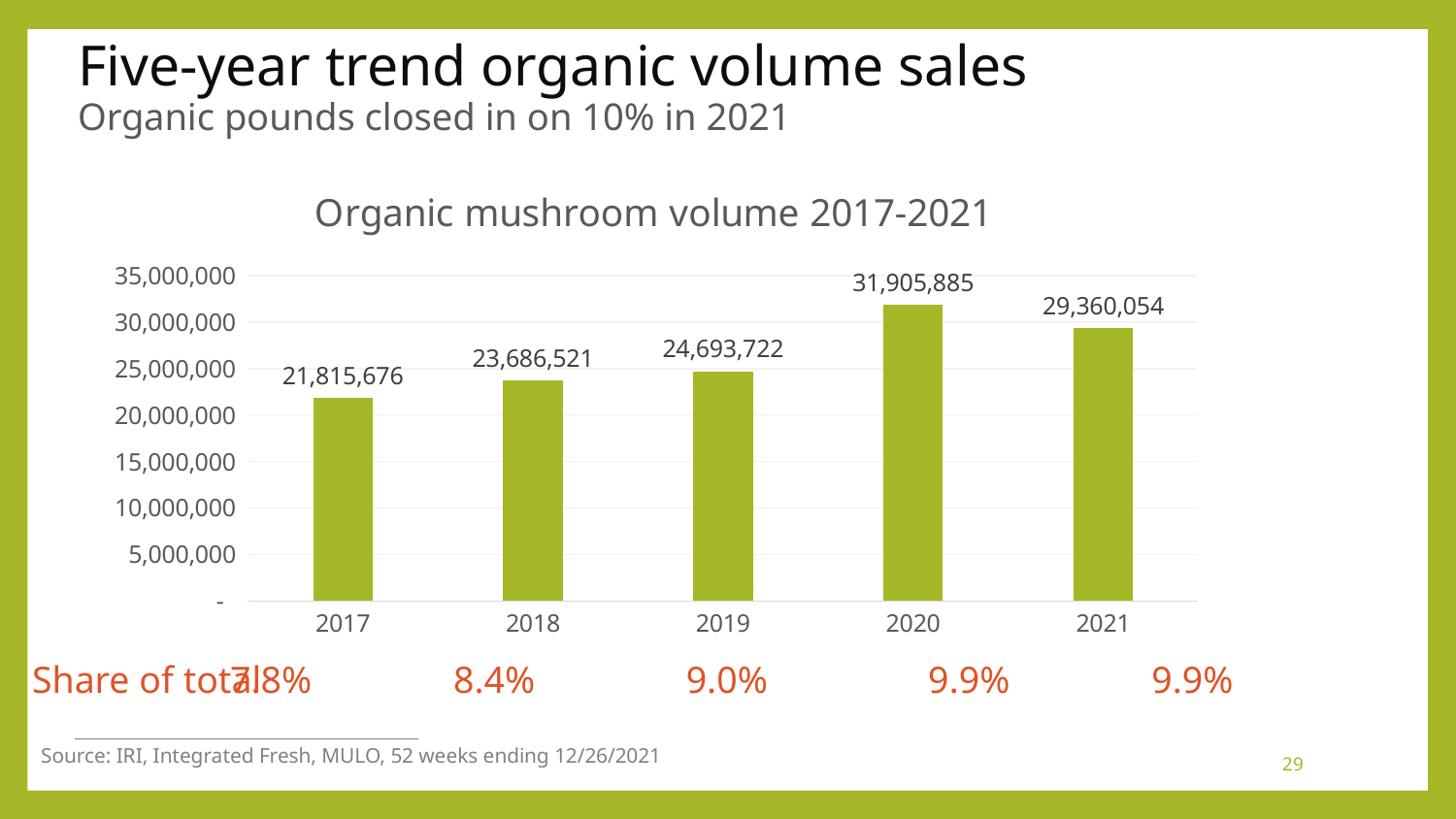
What is the organic mushroom volume for 2020? 31,905,885 What is the difference in organic mushroom volume between 2018 and 2017? 1,870,845 Did the organic mushroom volume rise or fall from 2020 to 2021? fall What is the organic mushroom volume for 2017? 21,815,676 How many years are shown in the chart? 5 Which year has the highest organic mushroom volume? 2020 What is the organic mushroom volume for 2021? 29,360,054 Is the organic mushroom volume for 2019 greater or less than 25,000,000? less Which year has a larger organic mushroom volume, 2019 or 2021? 2021 Which year has the lowest organic mushroom volume? 2017 What is the difference in organic mushroom volume between 2020 and 2021? 2,545,831 What kind of chart is shown on the slide? bar chart